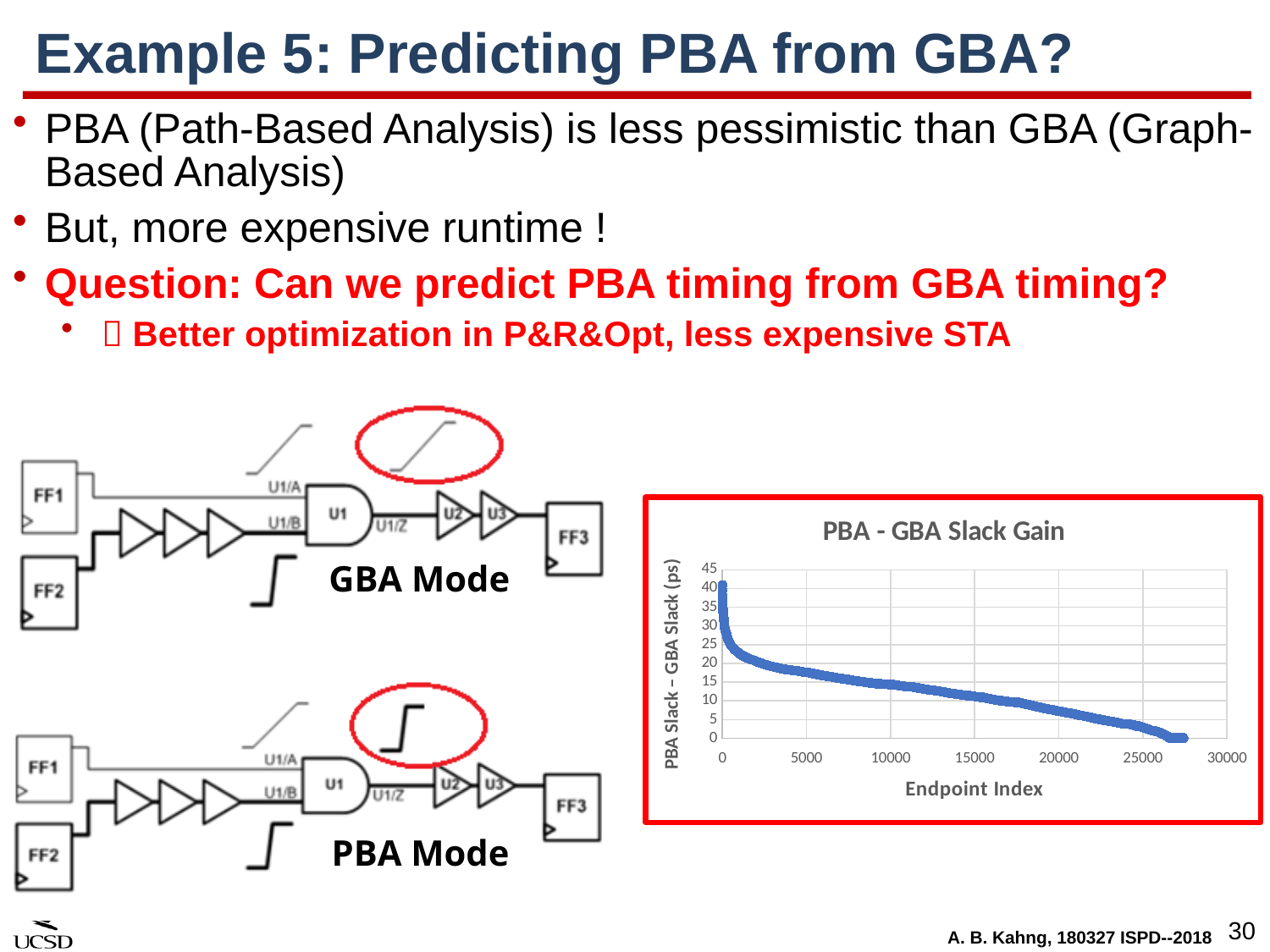
In the "PBA - GBA Slack Gain" chart, is the value at endpoint index 10000 greater or less than 20? less In the "PBA - GBA Slack Gain" chart, is the value at endpoint index 20000 greater or less than 10? less What is the label of the x axis of the "PBA - GBA Slack Gain" chart? Endpoint Index In the "PBA - GBA Slack Gain" chart, which is larger: the value at endpoint index 5000 or the value at endpoint index 20000? endpoint index 5000 In the "PBA - GBA Slack Gain" chart, is the value at endpoint index 15000 greater or less than 15? less What is the highest tick value shown on the y axis of the "PBA - GBA Slack Gain" chart? 45 What is the title of the chart on the slide? PBA - GBA Slack Gain In the "PBA - GBA Slack Gain" chart, do the values rise or fall as the endpoint index increases? fall What kind of chart is the "PBA - GBA Slack Gain" chart? scatter chart